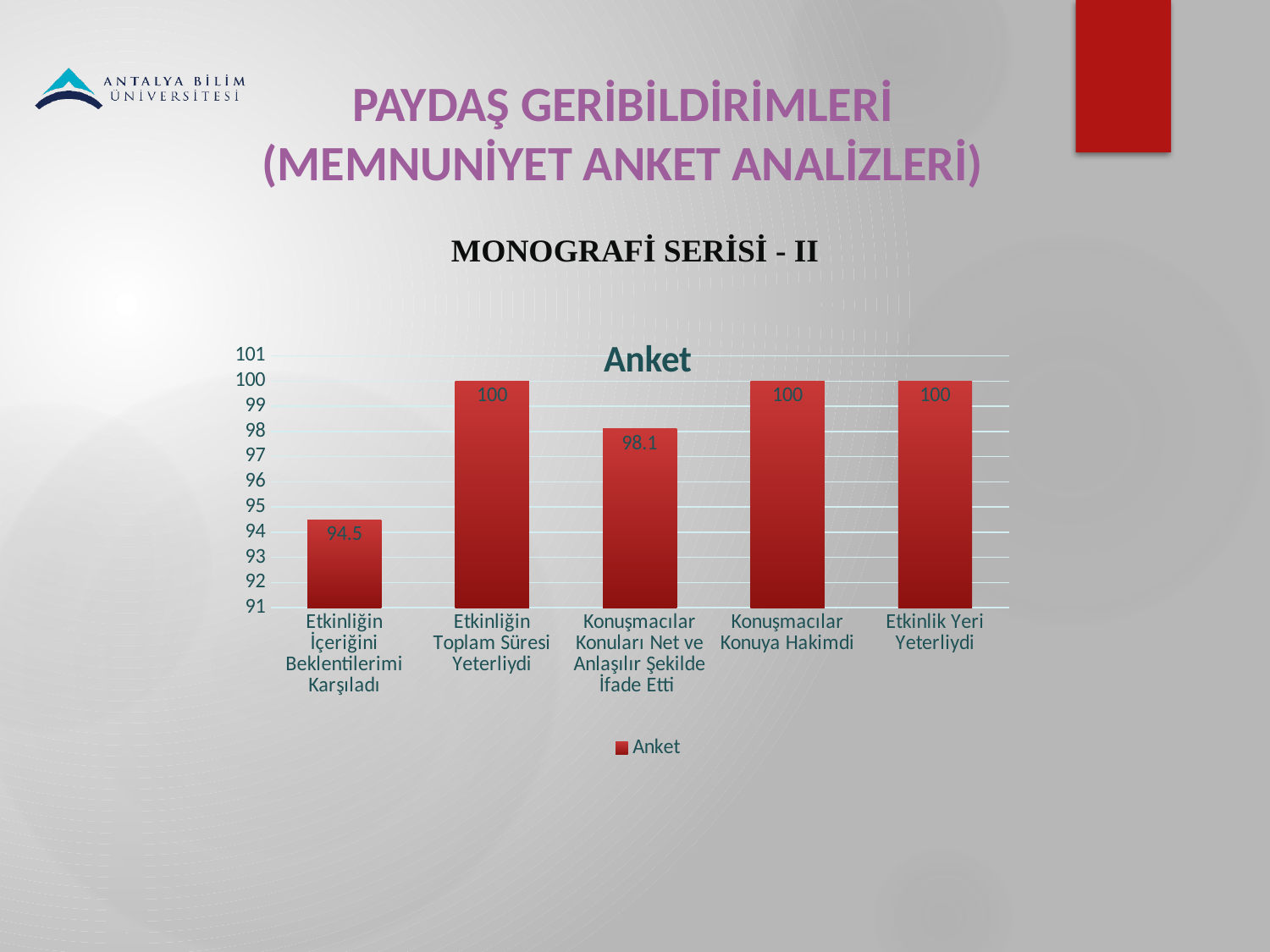
What is the difference between the values for "Konuşmacılar Konuya Hakimdi" and "Konuşmacılar Konuları Net ve Anlaşılır Şekilde İfade Etti"? 1.9 What is the title of the chart? Anket What is the value for "Konuşmacılar Konuları Net ve Anlaşılır Şekilde İfade Etti"? 98.1 Is the value for "Etkinliğin İçeriğini Beklentilerimi Karşıladı" greater or less than 96? less Which category has the lowest value? Etkinliğin İçeriğini Beklentilerimi Karşıladı How many categories are shown on the x axis? 5 How many series does the legend list? 1 Which is larger: the value for "Konuşmacılar Konuları Net ve Anlaşılır Şekilde İfade Etti" or the value for "Etkinliğin İçeriğini Beklentilerimi Karşıladı"? Konuşmacılar Konuları Net ve Anlaşılır Şekilde İfade Etti What is the value for "Etkinliğin İçeriğini Beklentilerimi Karşıladı"? 94.5 What is the difference between the values for "Etkinliğin Toplam Süresi Yeterliydi" and "Etkinliğin İçeriğini Beklentilerimi Karşıladı"? 5.5 What is the value for "Etkinlik Yeri Yeterliydi"? 100 What kind of chart is shown? bar chart